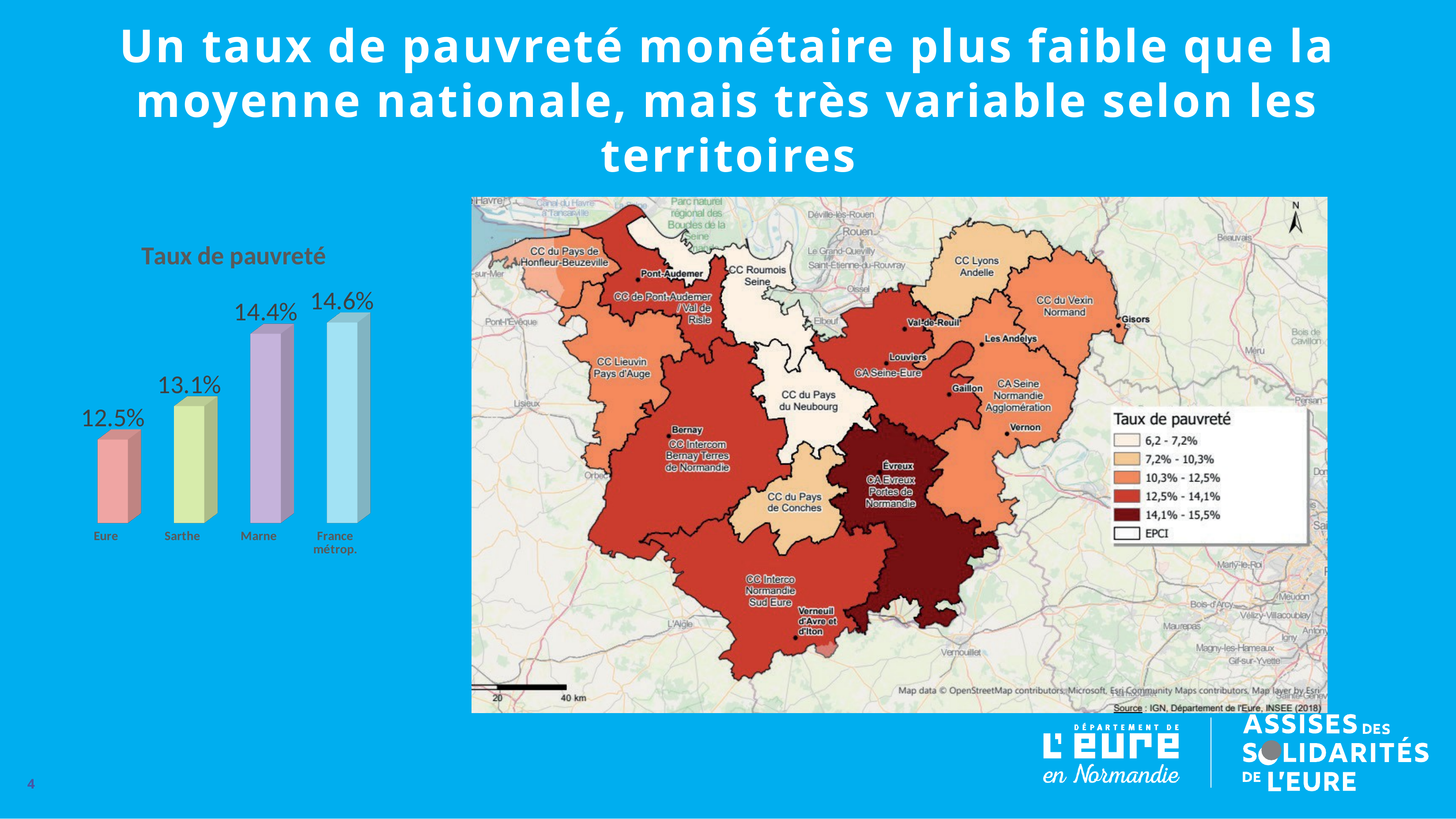
In the 'Taux de pauvreté' bar chart, which category has the highest value? France métrop. In the 'Taux de pauvreté' bar chart, which is larger, the value for Marne or the value for Sarthe? Marne In the 'Taux de pauvreté' bar chart, what is the value for France métrop.? 14.6% In the 'Taux de pauvreté' bar chart, what is the difference between the values for France métrop. and Eure? 2.1% In the 'Taux de pauvreté' bar chart, what is the value for Sarthe? 13.1% How many categories are shown in the 'Taux de pauvreté' bar chart? 4 In the 'Taux de pauvreté' bar chart, what is the value for Eure? 12.5% In the 'Taux de pauvreté' bar chart, do the values rise or fall from left to right? Rise In the 'Taux de pauvreté' bar chart, which category has the lowest value? Eure What kind of chart is the 'Taux de pauvreté' chart on the left of the slide? Bar chart In the 'Taux de pauvreté' bar chart, what is the value for Marne? 14.4% In the 'Taux de pauvreté' bar chart, what is the difference between the values for Sarthe and Eure? 0.6%